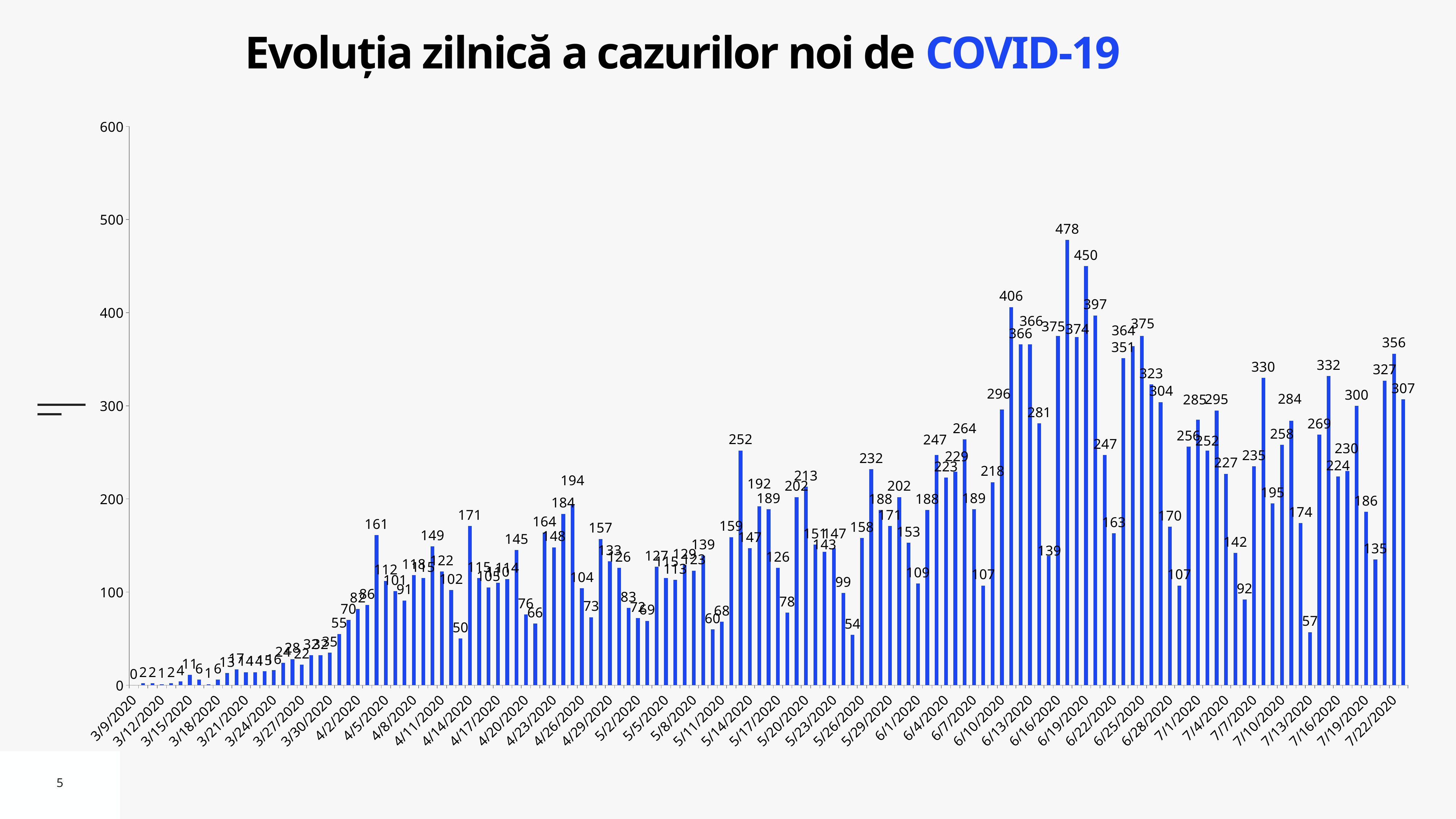
What kind of chart is shown on the slide? bar chart What is the title of the chart? Evoluția zilnică a cazurilor noi de COVID-19 What is the highest daily value shown in the chart? 478 Overall, do the daily values rise or fall from March to July along the x axis? rise What is the value of the first bar, for 3/9/2020? 0 Which is larger, the value for 7/21/2020 or the value for 7/22/2020? 7/22/2020 What is the value for 6/10/2020? 296 On which date does the chart reach its highest value? 6/17/2020 Is the highest bar in the chart greater or less than 500? less What is the value for 7/19/2020? 186